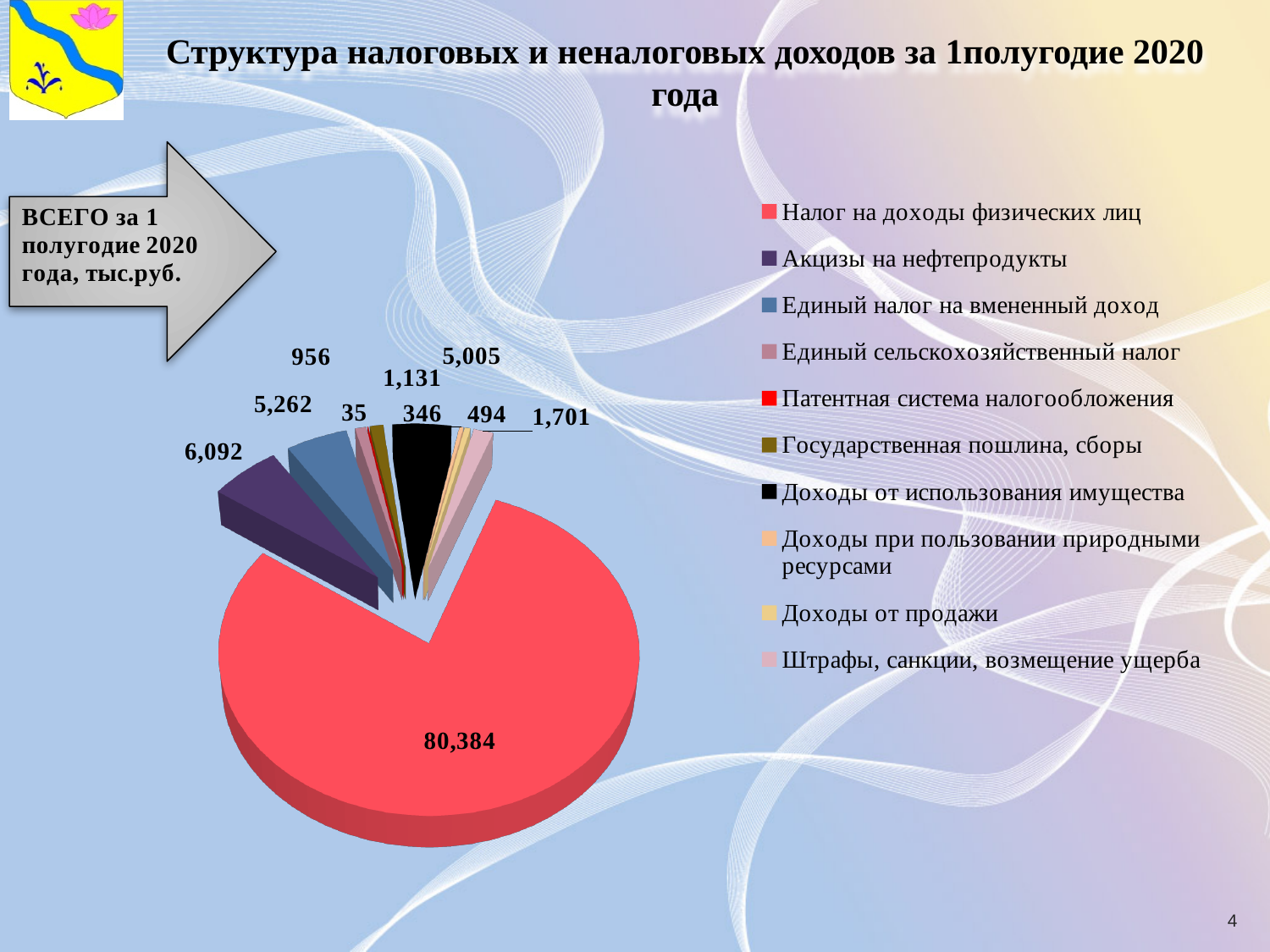
What is the title of the slide's chart? Структура налоговых и неналоговых доходов за 1полугодие 2020 года How many categories does the legend list? 10 What is the value for Доходы от использования имущества? 5,005 What kind of chart is shown on the slide? Pie chart What is the value for Налог на доходы физических лиц? 80,384 In what units are the values given, according to the arrow label? тыс.руб. What is the difference between Акцизы на нефтепродукты (6,092) and Единый налог на вмененный доход (5,262)? 830 What is the value for Единый налог на вмененный доход? 5,262 Which category has the largest slice of the pie? Налог на доходы физических лиц Which is larger, Акцизы на нефтепродукты or Единый налог на вмененный доход? Акцизы на нефтепродукты What is the value for Штрафы, санкции, возмещение ущерба? 1,701 What is the value for Акцизы на нефтепродукты? 6,092